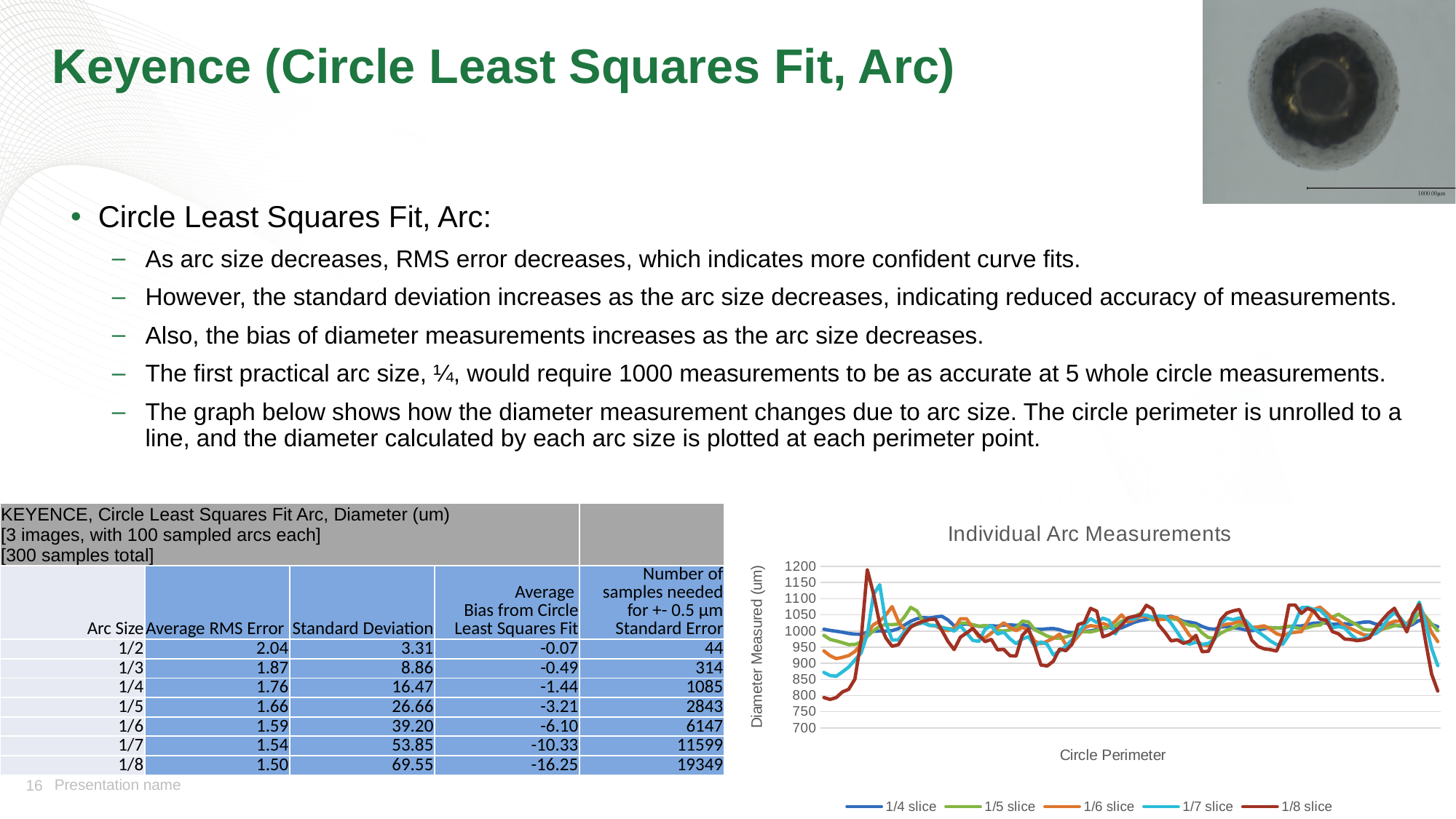
In the 'Individual Arc Measurements' chart, is the value of the 1/8 slice at the start of the circle perimeter greater or less than 850? less What is the y-axis label of the 'Individual Arc Measurements' chart? Diameter Measured (um) In the 'Individual Arc Measurements' chart, which series reaches the highest diameter value? 1/8 slice In the 'Individual Arc Measurements' chart, at the start of the circle perimeter, which is larger: the 1/4 slice or the 1/8 slice? 1/4 slice In the 'Individual Arc Measurements' chart, is the highest peak of the 1/8 slice greater or less than 1150? greater In the 'Individual Arc Measurements' chart, is the value of the 1/7 slice at the start of the circle perimeter greater or less than 950? less In the 'Individual Arc Measurements' chart, which series reaches the lowest diameter value? 1/8 slice What kind of chart is 'Individual Arc Measurements'? line chart What is the title of the chart on the slide? Individual Arc Measurements In the 'Individual Arc Measurements' chart, does the 1/8 slice rise or fall at the far right end of the circle perimeter? fall How many series does the legend of the 'Individual Arc Measurements' chart list? 5